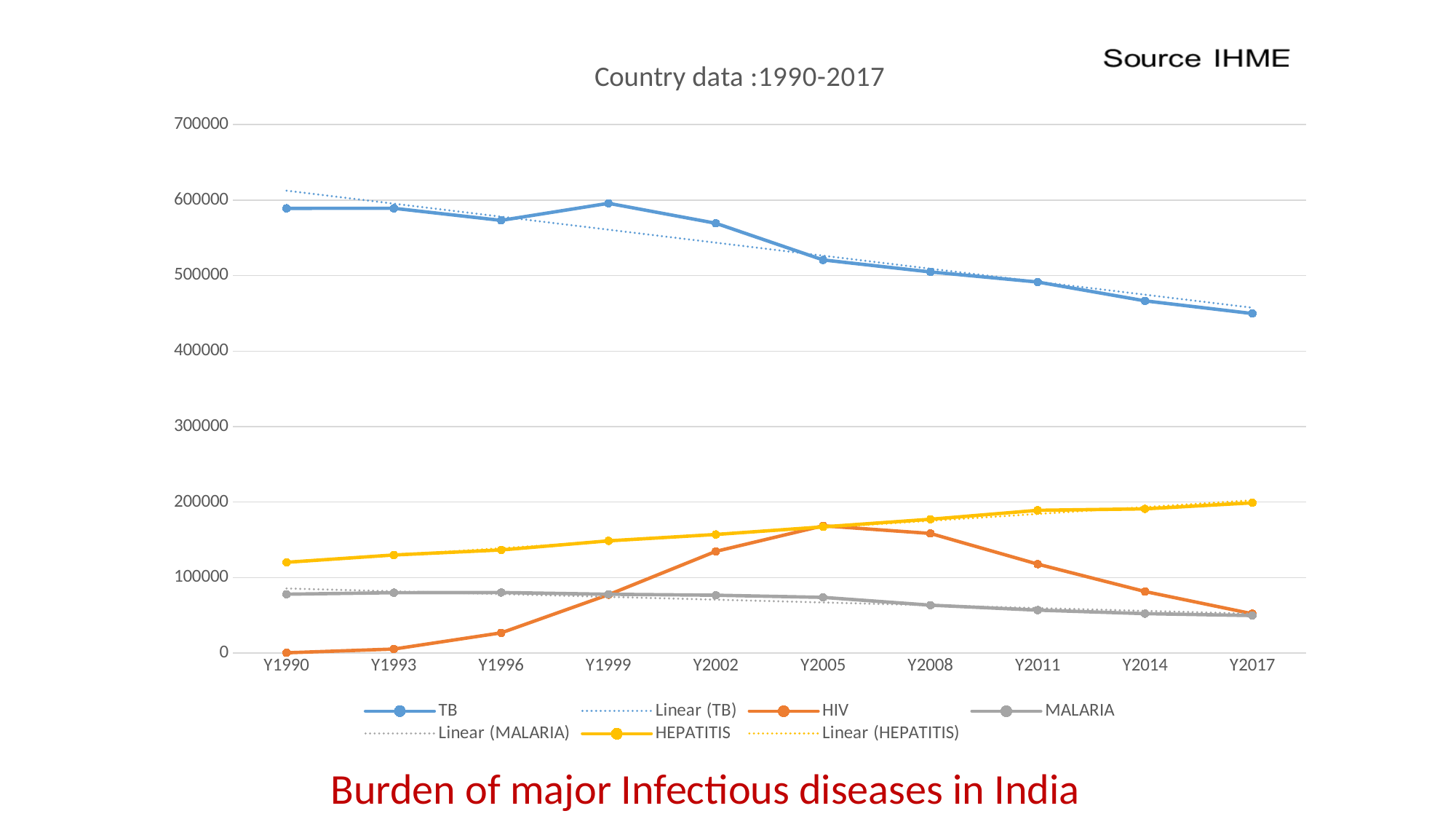
How many year categories are shown on the x axis? 10 Is the value for MALARIA at Y1990 greater or less than 100000? less Does the HEPATITIS series rise or fall from Y1990 to Y2017? rise Does the TB series rise or fall from Y1990 to Y2017? fall In which year does the HIV series reach its highest value? Y2005 Which series has the highest value at Y2017? TB How many entries does the legend list? 7 Is the value for TB at Y1990 greater or less than 500000? greater What is the title shown above the chart? Country data :1990-2017 At Y2017, which is larger, HEPATITIS or HIV? HEPATITIS Which series has the lowest value at Y1990? HIV What kind of chart is shown on the slide? line chart